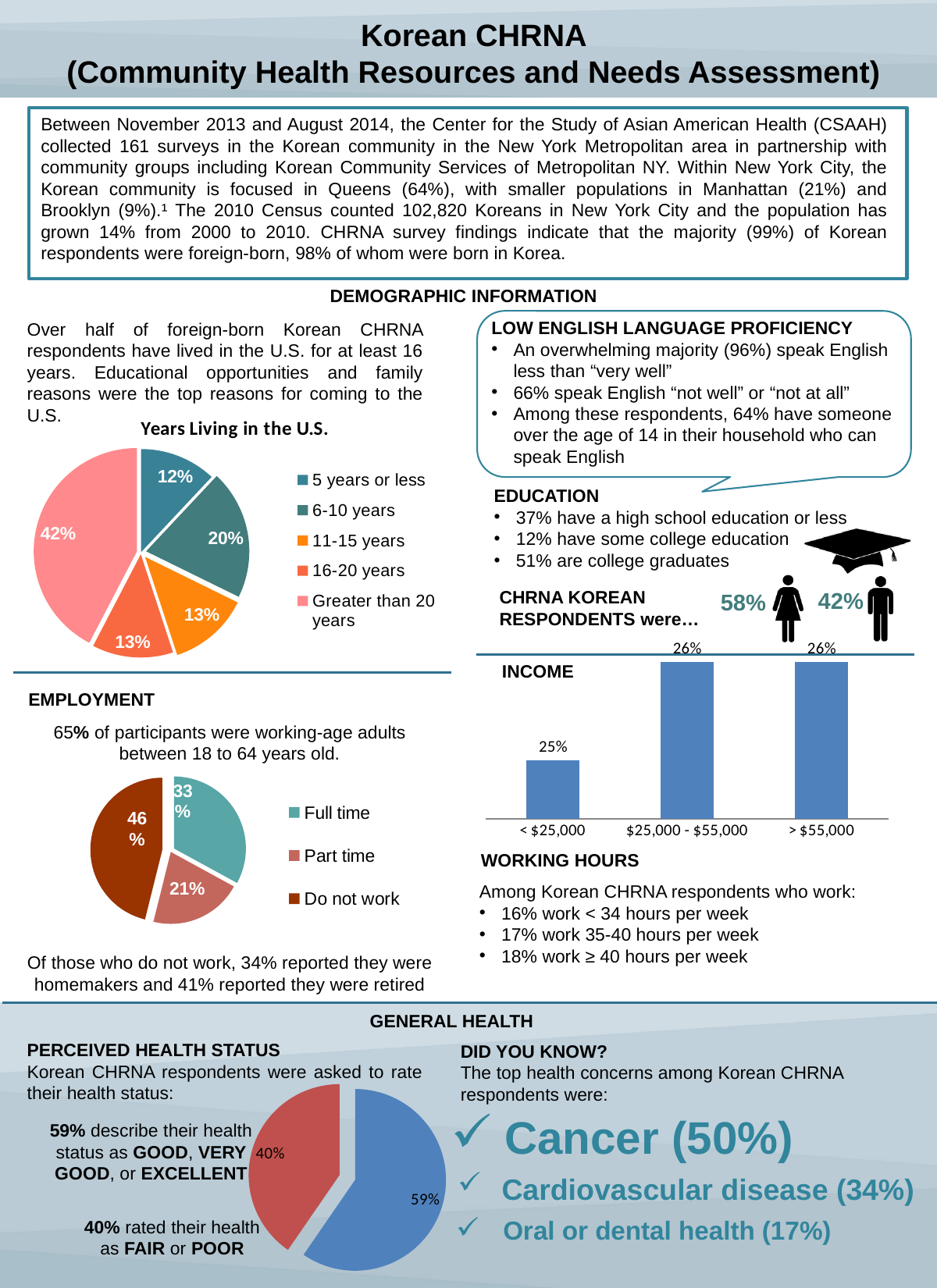
In the Perceived Health Status pie chart, what share of respondents rated their health as fair or poor? 40% In the Employment pie chart, what share of participants work part time? 21% In the "Years Living in the U.S." pie chart, what share of respondents have lived in the U.S. for greater than 20 years? 42% In the Income bar chart, how many income categories are shown? 3 What kind of chart is the Income chart? Bar chart In the "Years Living in the U.S." pie chart, how many categories does the legend list? 5 In the "Years Living in the U.S." pie chart, what is the difference between the share for 6-10 years and the share for 5 years or less? 8% In the Perceived Health Status pie chart, what is the difference between the two slices? 19% In the Employment pie chart, which is larger: the share for Full time or the share for Part time? Full time In the "Years Living in the U.S." pie chart, which category has the smallest share? 5 years or less In the Employment pie chart, which category has the largest share? Do not work In the Income bar chart, what is the value for the < $25,000 category? 25%